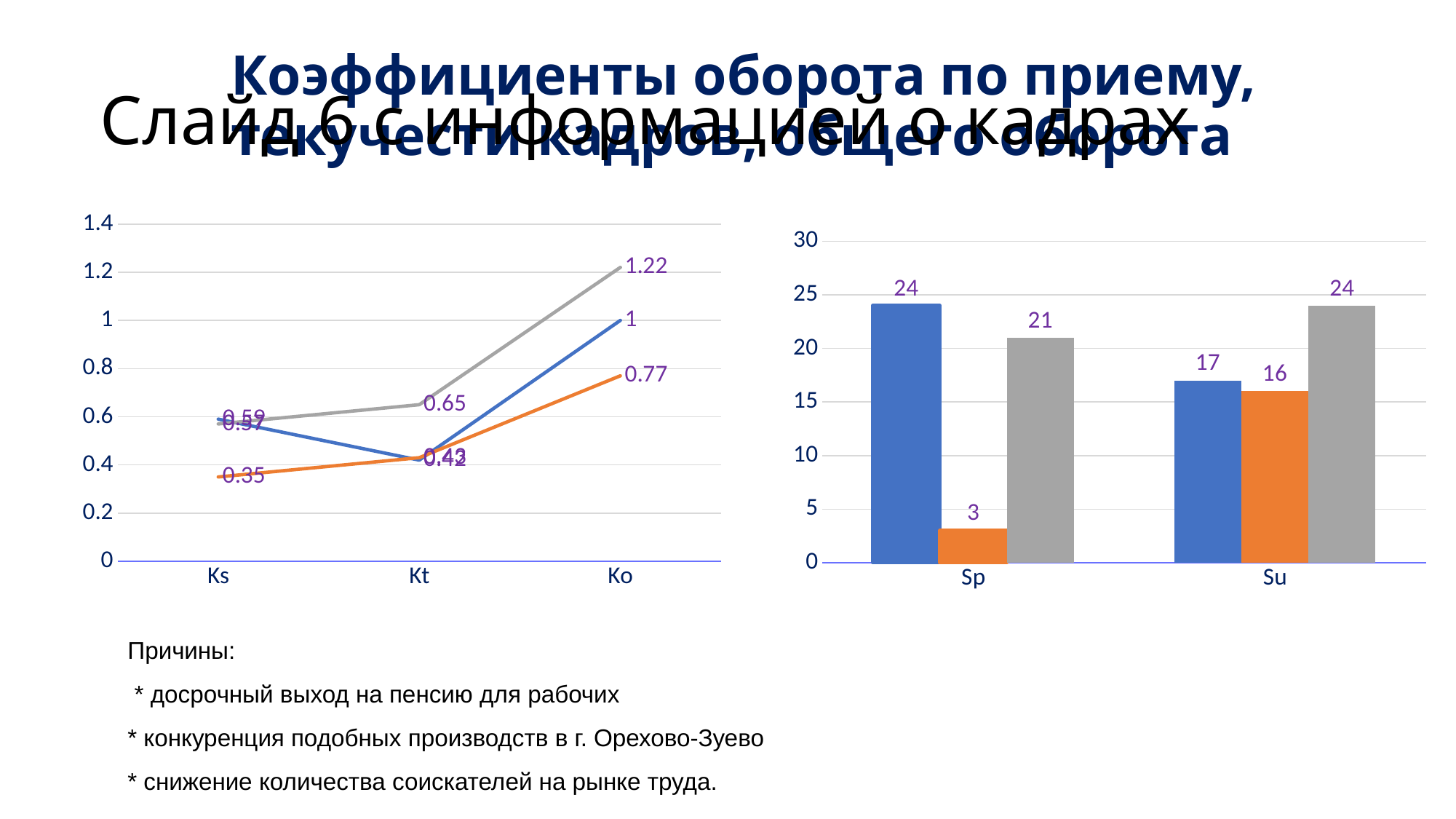
In the bar chart on the right, what is the value of the gray bar for Su? 24 What kind of chart is the chart on the left of the slide? line chart What kind of chart is the chart on the right of the slide? bar chart In the line chart on the left, what is the value of the gray line at Kt? 0.65 In the line chart on the left, does the gray line rise or fall from Ks to Ko? rise In the bar chart on the right, which is larger for Su: the blue bar or the gray bar? gray bar In the line chart on the left, what is the value of the gray line at Ko? 1.22 In the bar chart on the right, what is the difference between the blue bar and the gray bar for Sp? 3 In the bar chart on the right, which bar is the lowest? orange bar for Sp In the line chart on the left, what is the value of the orange line at Ks? 0.35 In the bar chart on the right, what is the value of the orange bar for Sp? 3 In the line chart on the left, how many categories are shown on the x axis? 3